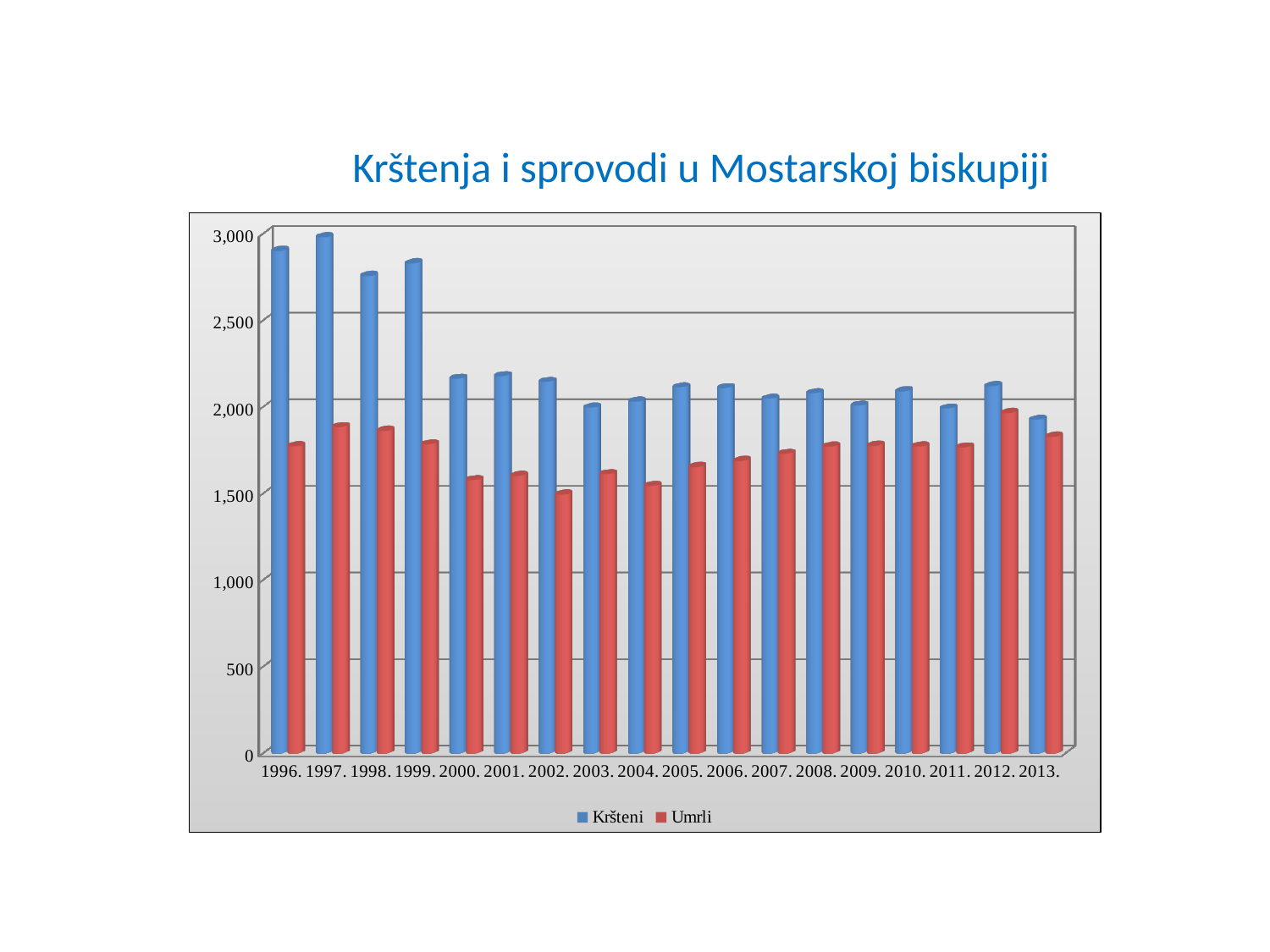
Is the Kršteni value for 2000 greater or less than 2,500? less In which year is the Umrli value highest? 2012. Which is larger in 1996, Kršteni or Umrli? Kršteni How many years are shown on the x axis? 18 Is the Kršteni value for 1996 greater or less than 2,500? greater Do the Kršteni values overall rise or fall from 1996 to 2013? fall Is the Umrli value for 1997 greater or less than 1,500? greater How many series does the legend list? 2 In which year is the Umrli value lowest? 2002. What kind of chart is shown on the slide? bar chart In which year is the Kršteni value highest? 1997.